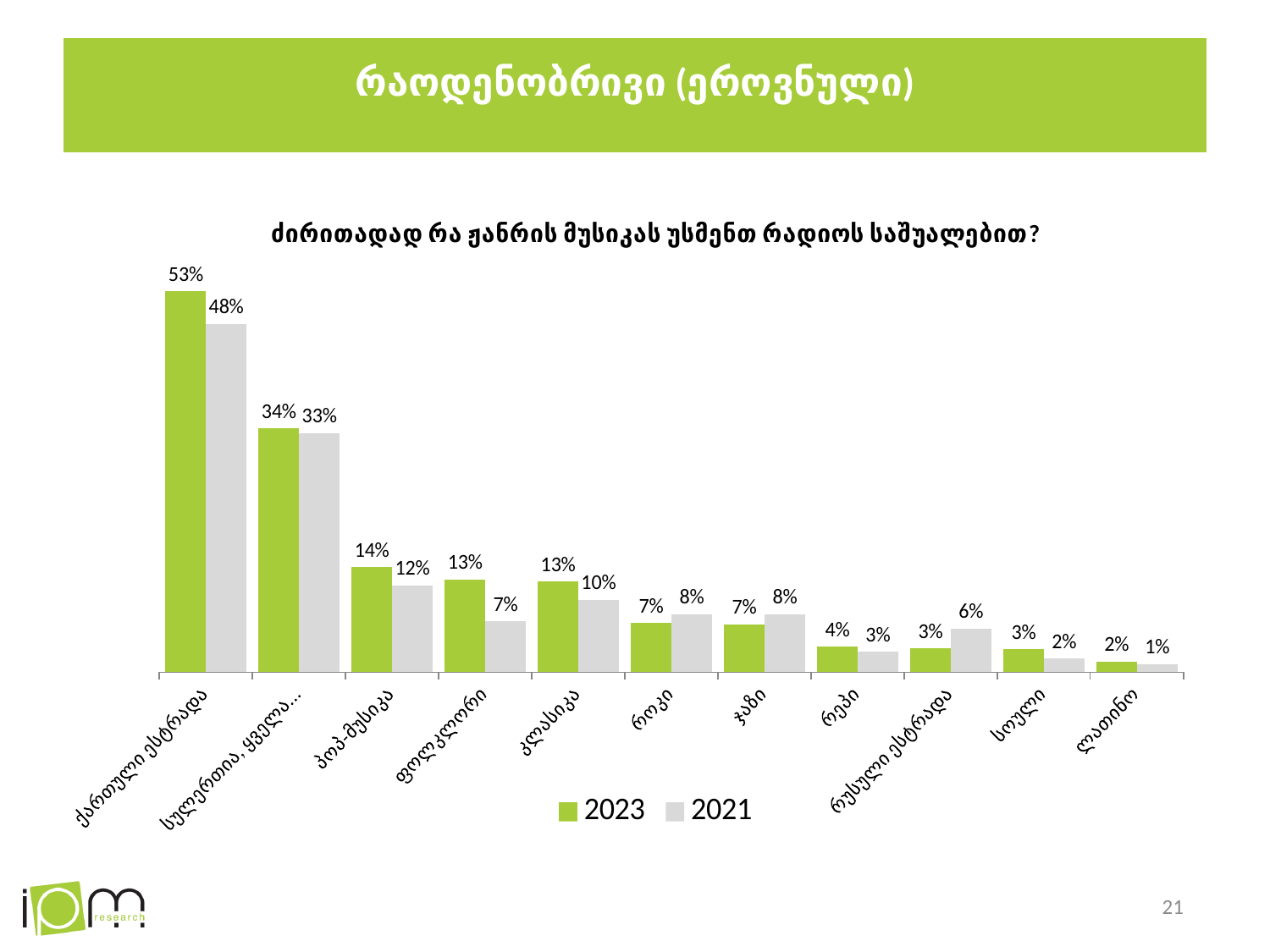
What is the difference between the 2023 and 2021 values for ფოლკლორი? 6% Which category has the lowest 2021 value? ლათინო How many series does the legend list? 2 Which is larger for რუსული ესტრადა: the 2023 value or the 2021 value? 2021 What kind of chart is shown on the slide? Bar chart What is the 2021 value for რუსული ესტრადა? 6% Which is larger for პოპ-მუსიკა: the 2023 value or the 2021 value? 2023 What is the difference between the 2023 and 2021 values for ქართული ესტრადა? 5% How many categories are shown on the x axis? 11 What is the 2023 value for ქართული ესტრადა? 53% What is the 2021 value for ფოლკლორი? 7% Which category has the highest 2023 value? ქართული ესტრადა